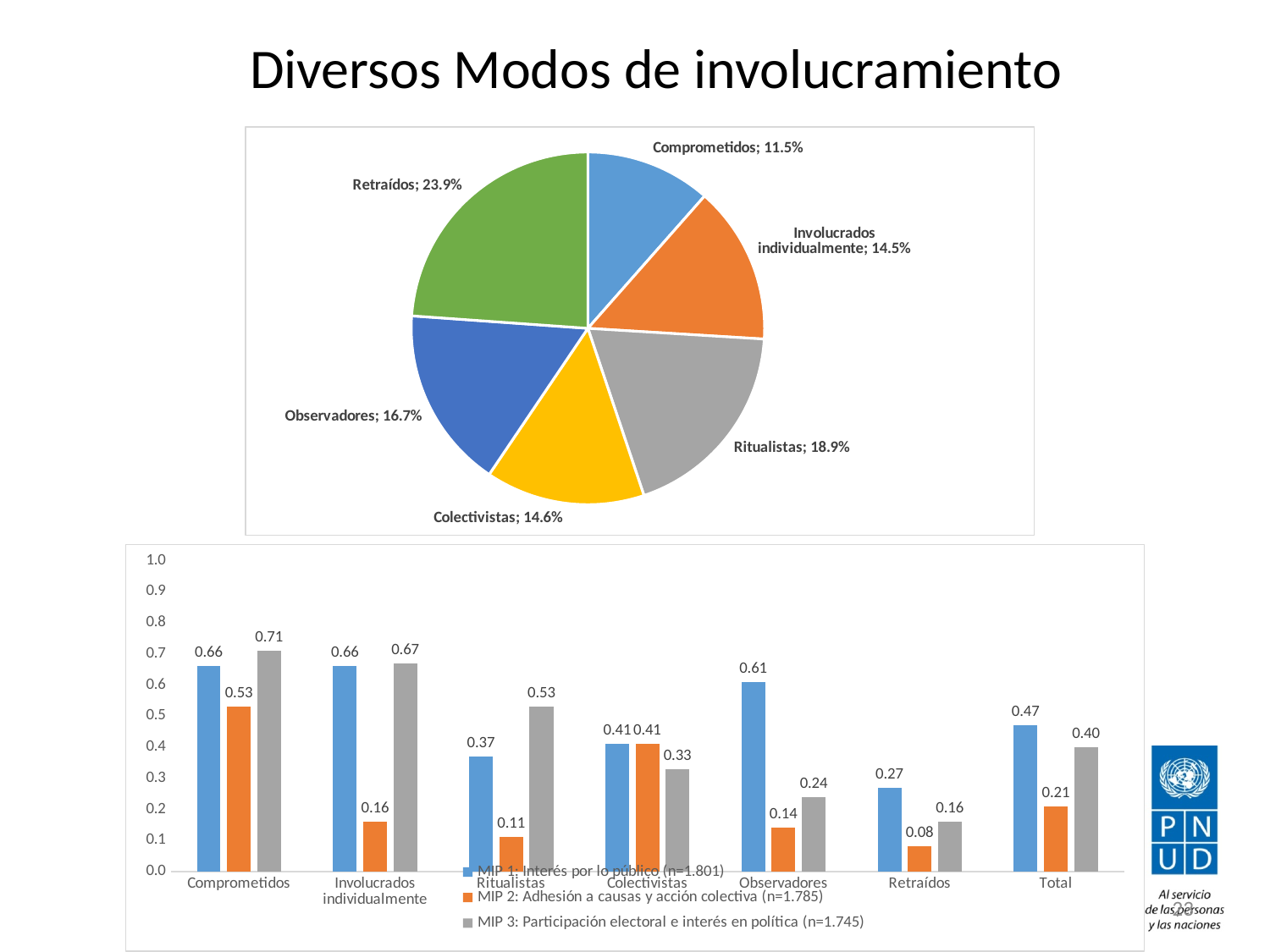
In the bar chart at the bottom of the slide, how many series does the legend list? 3 In the pie chart at the top of the slide, what share does the Retraídos slice have? 23.9% In the pie chart at the top of the slide, which category has the largest slice? Retraídos In the pie chart at the top of the slide, how many slices are there? 6 In the bar chart at the bottom of the slide, what is the MIP 2 value for Observadores? 0.14 In the bar chart at the bottom of the slide, what is the MIP 3 value for Comprometidos? 0.71 In the bar chart at the bottom of the slide, which is larger for Ritualistas: the MIP 1 value or the MIP 3 value? MIP 3 What kind of chart is the chart at the bottom of the slide? Bar chart In the bar chart at the bottom of the slide, what is the difference between the MIP 1 and MIP 2 values for Total? 0.26 In the pie chart at the top of the slide, which category has the smallest slice? Comprometidos In the pie chart at the top of the slide, what is the difference between the Ritualistas share and the Observadores share? 2.2% In the bar chart at the bottom of the slide, which category has the lowest MIP 2 value? Retraídos